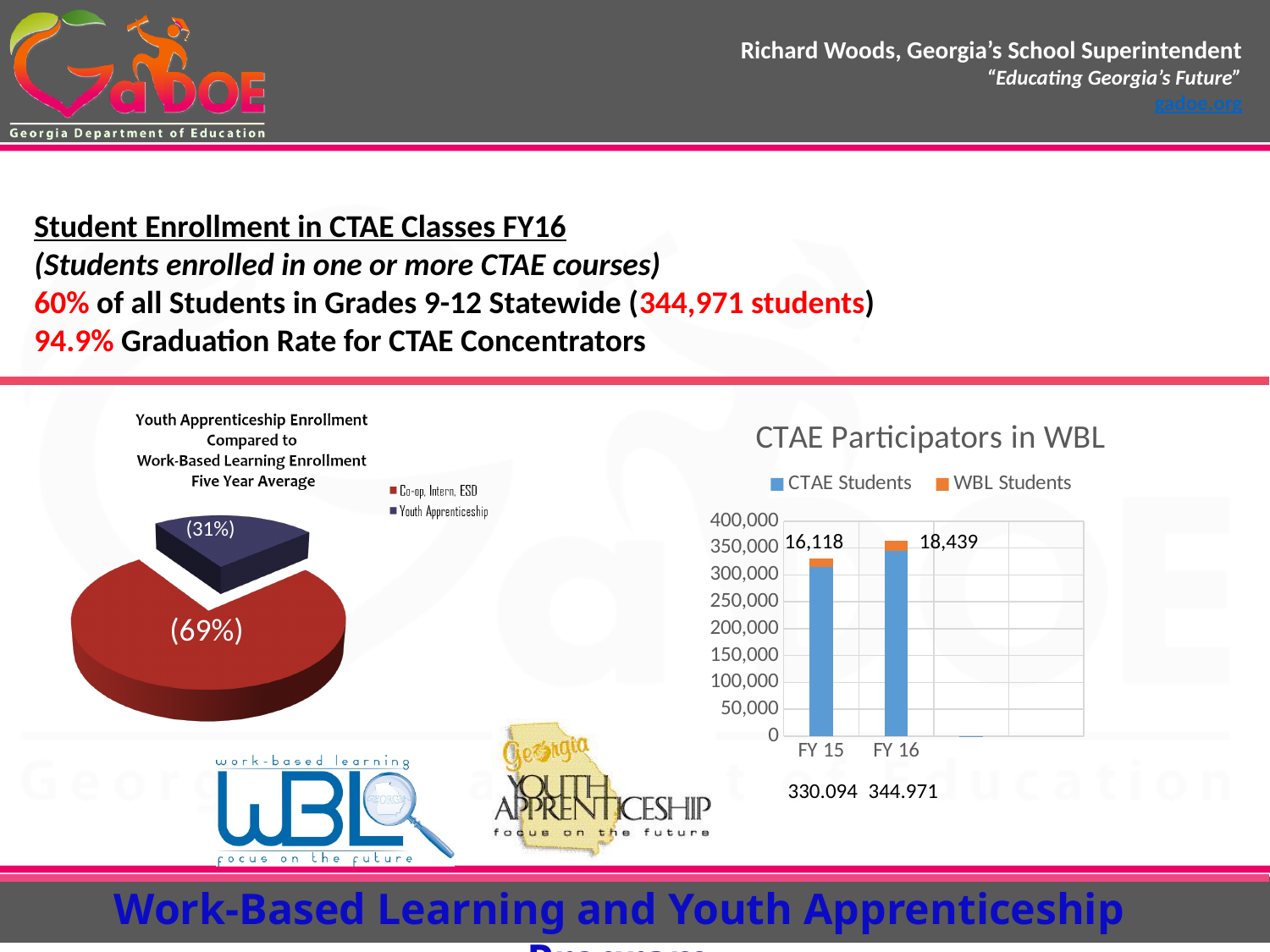
What kind of chart is 'CTAE Participators in WBL'? Bar chart In the 'CTAE Participators in WBL' chart, what is the value for WBL Students in FY 15? 16,118 In the pie chart on the left, what share of enrollment is Youth Apprenticeship? 31% In the 'CTAE Participators in WBL' chart, do the WBL Students values rise or fall from FY 15 to FY 16? Rise In the pie chart on the left, which slice is larger: Co-op, Intern, ESD or Youth Apprenticeship? Co-op, Intern, ESD In the 'CTAE Participators in WBL' chart, how many series does the legend list? 2 In the 'CTAE Participators in WBL' chart, is the CTAE Students value for FY 15 greater or less than 300,000? greater In the 'CTAE Participators in WBL' chart, what is the value for WBL Students in FY 16? 18,439 How many slices does the pie chart on the left have? 2 In the 'CTAE Participators in WBL' chart, what is the difference between WBL Students in FY 16 and FY 15? 2,321 What kind of chart is the chart on the left of the slide? Pie chart In the pie chart on the left, what share of enrollment is Co-op, Intern, ESD? 69%